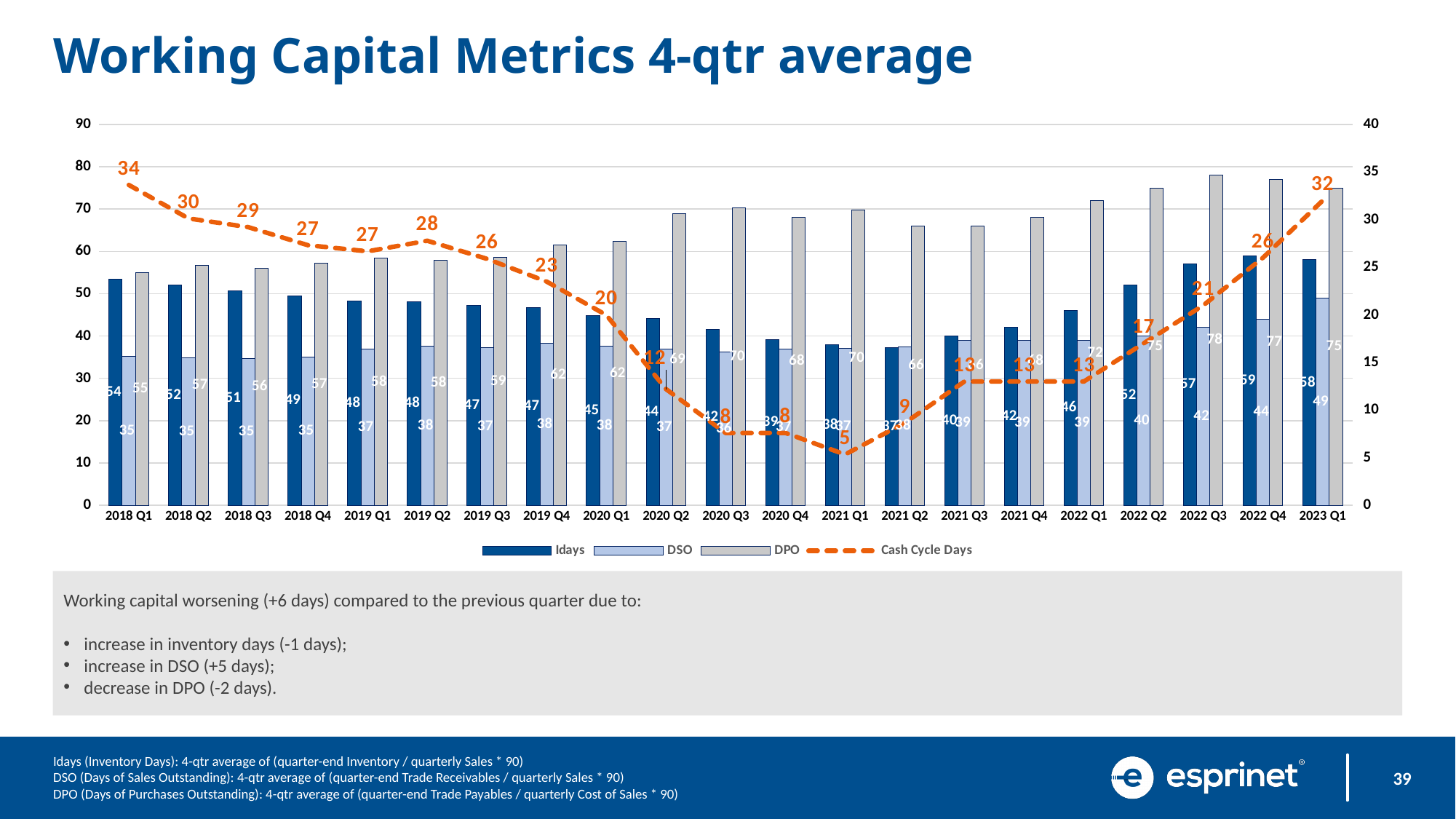
What is the difference between the DSO value for 2023 Q1 and the DSO value for 2022 Q4? 5 In which quarter is the Cash Cycle Days value highest? 2018 Q1 What is the DSO value for 2023 Q1? 49 What is the DPO value for 2022 Q3? 78 In which quarter is the Cash Cycle Days value lowest? 2021 Q1 Does the Cash Cycle Days line rise or fall from 2021 Q1 to 2023 Q1? rise Which series is shown as the orange dashed line? Cash Cycle Days What is the Idays value for 2018 Q1? 54 What is the Cash Cycle Days value for 2023 Q1? 32 How many series does the legend list? 4 Which is larger, the Idays value for 2018 Q1 or the Idays value for 2023 Q1? 2023 Q1 How many quarters are shown on the x axis? 21